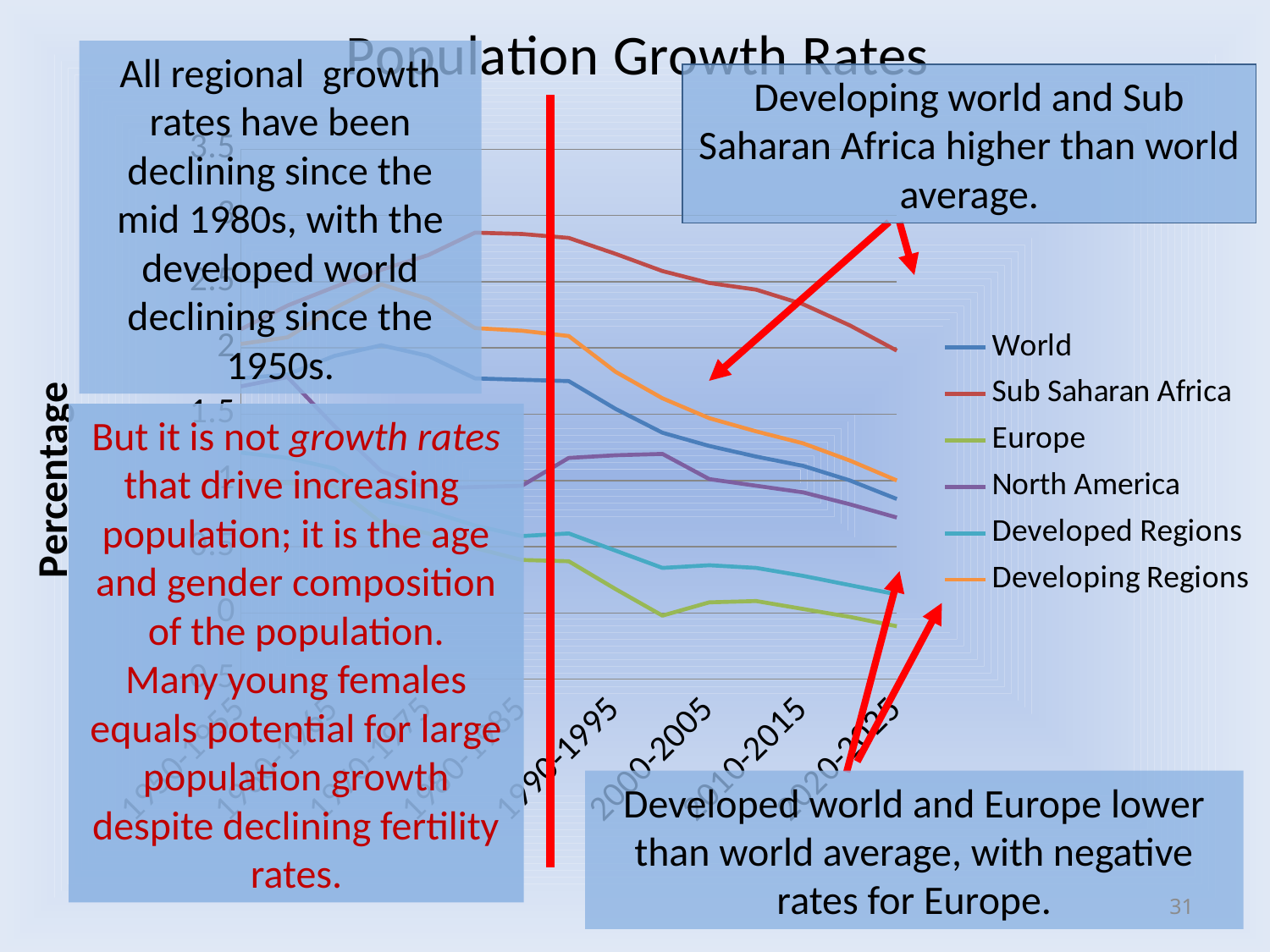
Which series has the lowest value at 2020-2025? Europe What is the label on the vertical axis of the chart? Percentage At 1990-1995, which is larger: Sub Saharan Africa or World? Sub Saharan Africa Does the Sub Saharan Africa line rise or fall from 1990-1995 to 2020-2025? fall At 2020-2025, which is larger: Developing Regions or Developed Regions? Developing Regions What kind of chart is shown on the slide? line chart What is the title of the chart? Population Growth Rates Is the value for Sub Saharan Africa at 1990-1995 greater or less than 2.5? greater Is the value for World at 2020-2025 greater or less than 1? less Is the value for Developed Regions at 2020-2025 greater or less than 0.5? less Which series has the highest value at 2020-2025? Sub Saharan Africa How many series does the legend list? 6